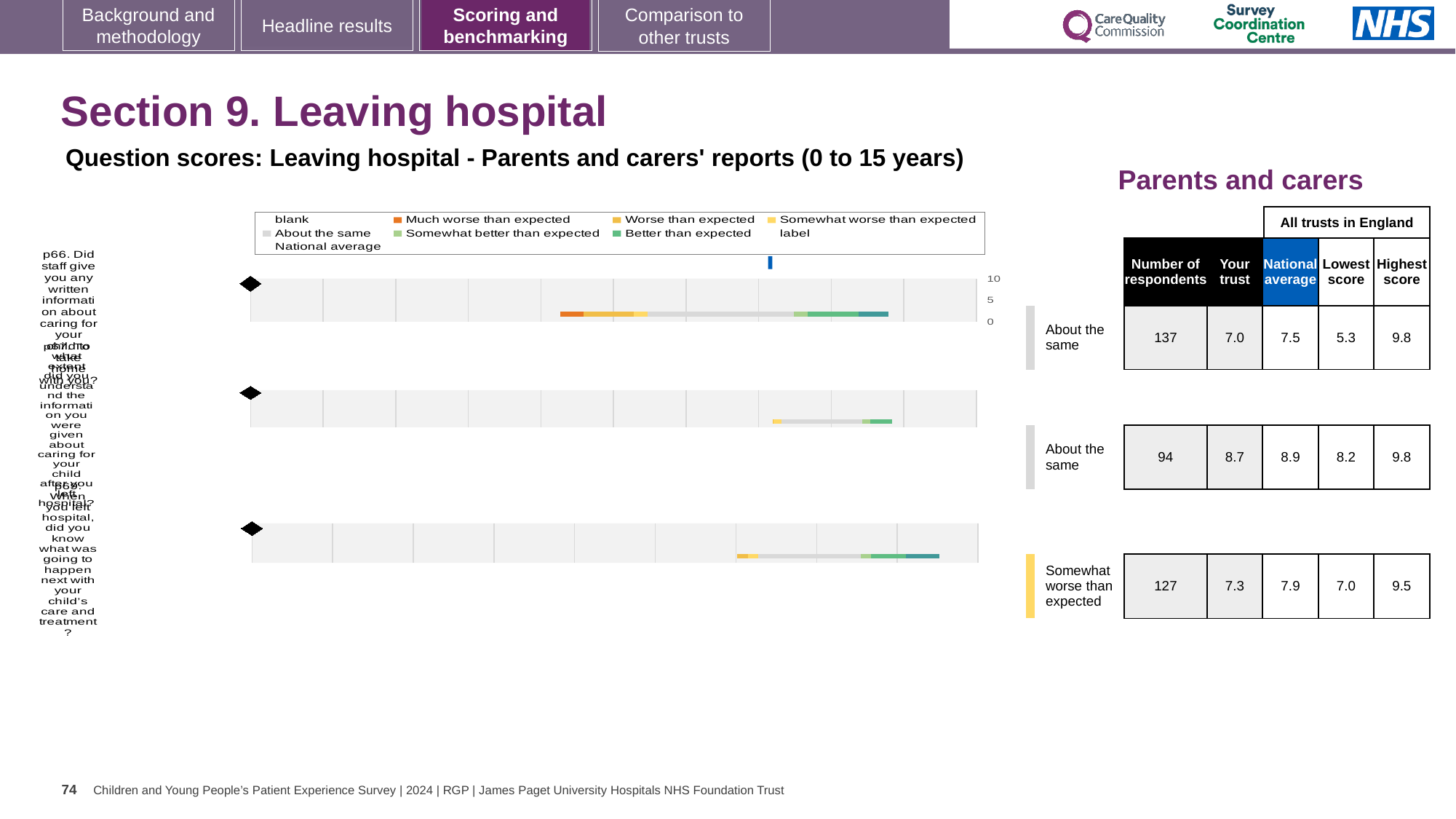
In the legend, what colour represents 'About the same'? grey How many question-score charts are shown on the slide? 3 For the third (bottom) chart, what is the highest score across all trusts in England? 9.5 For the first (top) chart, what is the national average score shown in the table? 7.5 Which of the three charts has the highest 'Your trust' score in the table? the second (middle) chart, 8.7 What kind of chart is used for the question scores on this slide? bar chart In the legend, what colour represents 'Much worse than expected'? orange For the second (middle) chart, how many respondents are shown in the table? 94 For the third (bottom) chart, what is the difference between the national average (7.9) and the 'Your trust' score (7.3)? 0.6 For the first (top) chart, which is larger: the 'Your trust' score or the national average? National average For the first (top) chart, what is the 'Your trust' score shown in the table? 7.0 For the second (middle) chart, what is the lowest score across all trusts in England? 8.2